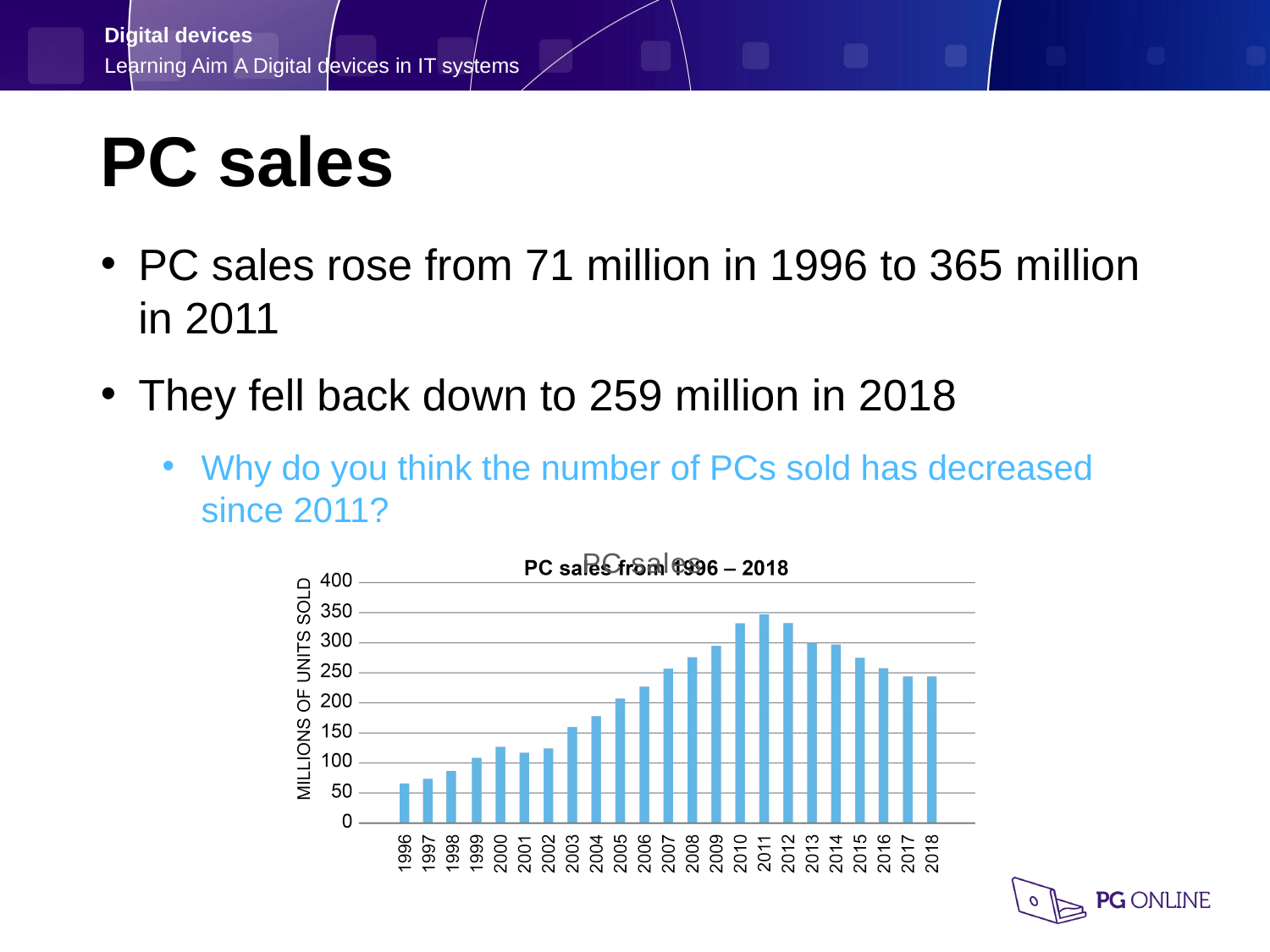
Is the value for 2011 greater or less than 300? greater What is the label on the vertical axis of the chart? MILLIONS OF UNITS SOLD Is the value for 2018 greater or less than 300? less What kind of chart is shown on the slide? bar chart Do the values rise or fall from 2011 to 2018? fall Which year has the highest PC sales in the chart? 2011 Is the value for 1996 greater or less than 100? less Which year has the larger value, 2004 or 2016? 2016 How many years (bars) are plotted in the chart? 23 What is the title of the chart? PC sales from 1996 – 2018 Which year has the lowest PC sales in the chart? 1996